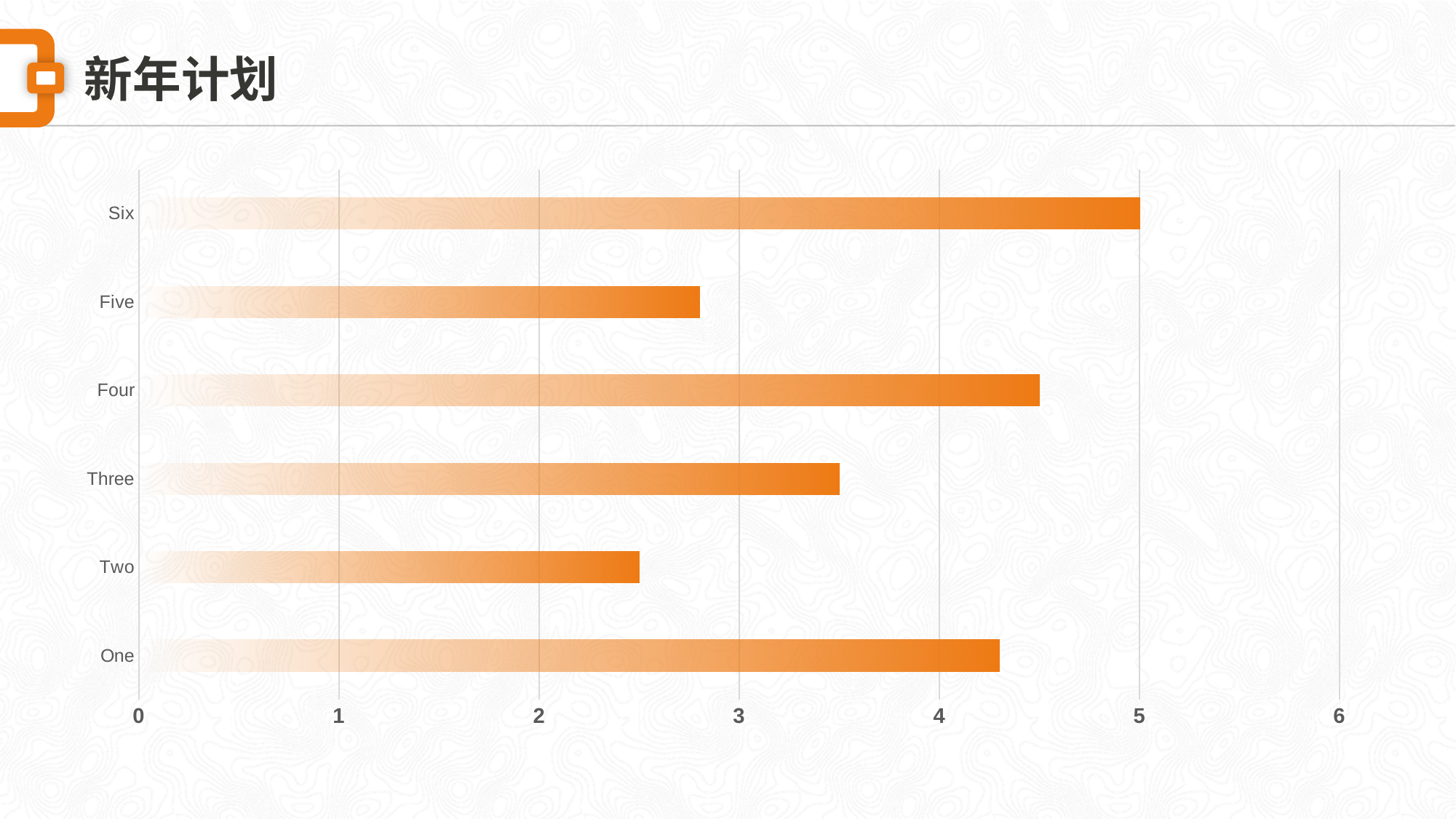
What kind of chart is shown on the slide? bar chart Is the value for One greater or less than 4? greater What is the title shown at the top of the slide? 新年计划 Which is larger, the value for Four or the value for Five? Four Is the value for Five greater or less than 3? less What is the value for Six? 5 How many categories are plotted in the chart? 6 Is the value for Three greater or less than 3? greater Which is larger, the value for Two or the value for Three? Three Which category has the lowest value? Two Which category has the highest value? Six